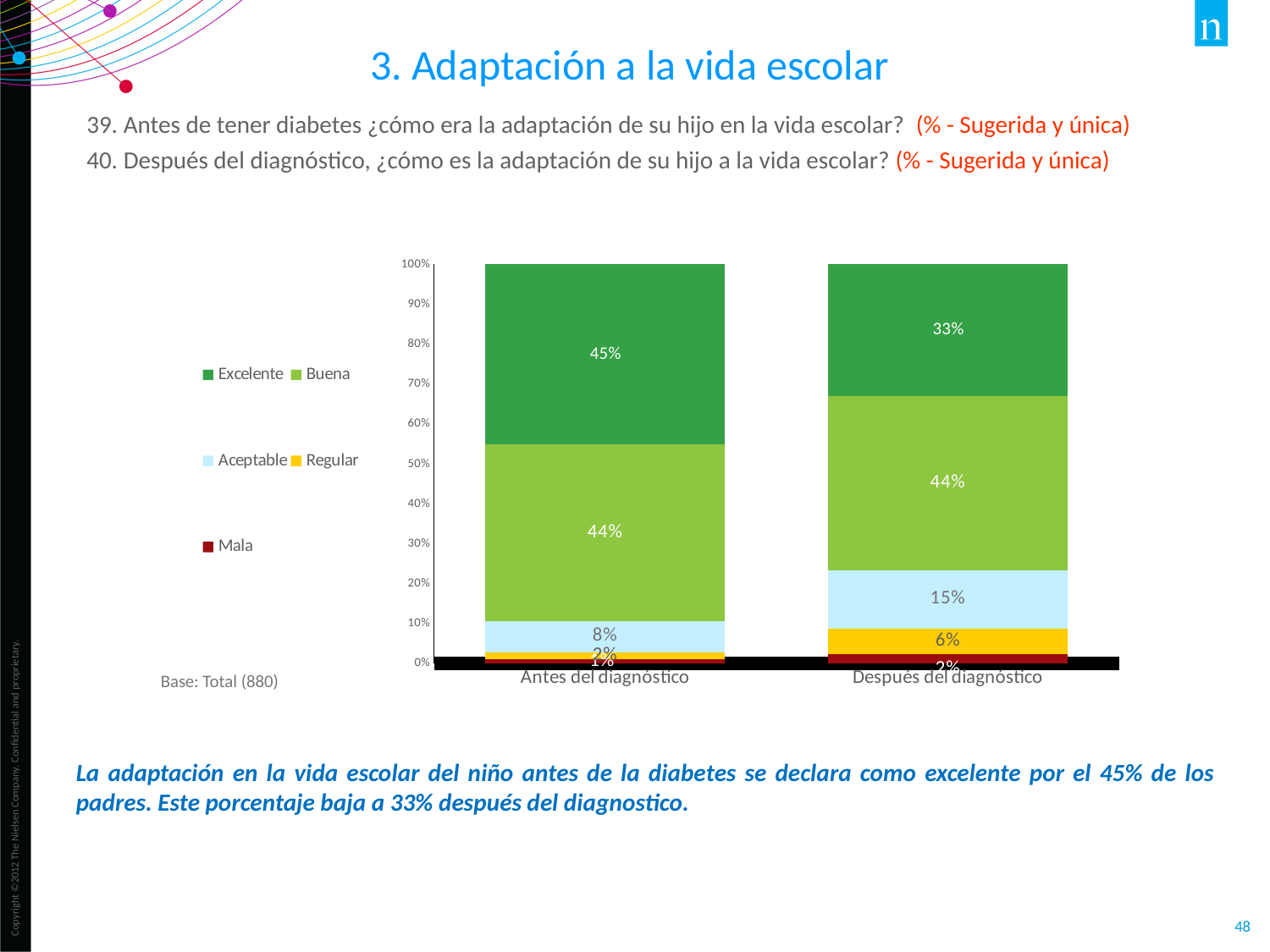
Which series has the highest value in the Después del diagnóstico bar? Buena What is the value for Aceptable in the Después del diagnóstico bar? 15% What is the value for Buena in the Antes del diagnóstico bar? 44% Which series has the highest value in the Antes del diagnóstico bar? Excelente What is the value for Regular in the Después del diagnóstico bar? 6% How many series does the legend list? 5 What is the value for Excelente in the Después del diagnóstico bar? 33% How many categories are shown on the x axis? 2 What is the difference between the Excelente values for Antes del diagnóstico and Después del diagnóstico? 12 percentage points What is the value for Excelente in the Antes del diagnóstico bar? 45% What type of chart is shown on the slide? Stacked bar chart Which is larger, the Aceptable value for Antes del diagnóstico or for Después del diagnóstico? Después del diagnóstico